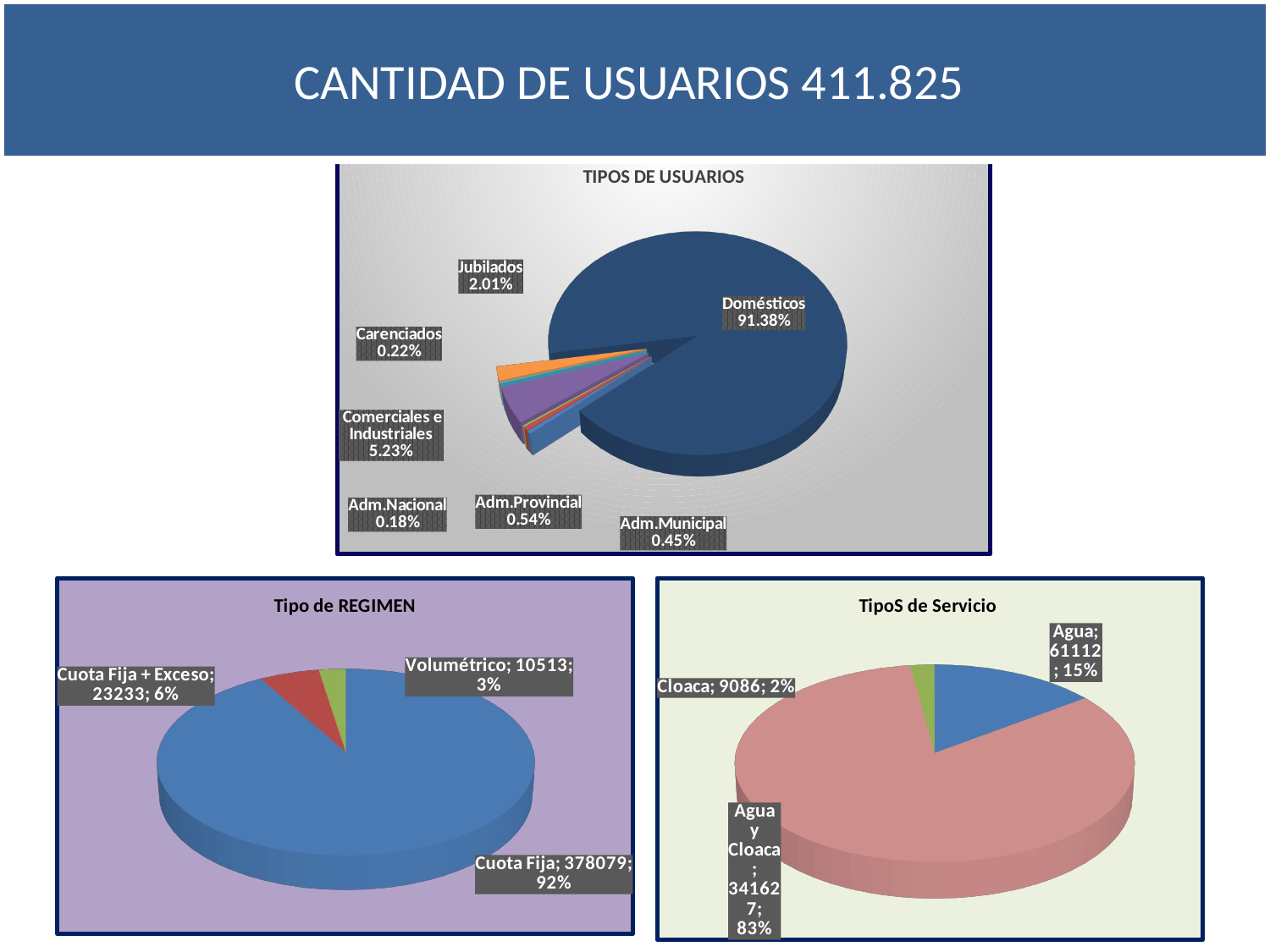
In the 'TIPOS DE USUARIOS' chart, which category has the smallest share? Adm.Nacional In the 'Tipo de REGIMEN' chart, what is the value for Cuota Fija? 378079 In the 'TIPOS DE USUARIOS' chart, how many categories are shown? 7 In the 'TipoS de Servicio' chart, what is the value for Agua y Cloaca? 341627 In the 'TIPOS DE USUARIOS' chart, what is the difference in percentage points between Adm.Provincial and Adm.Municipal? 0.09 In the 'TIPOS DE USUARIOS' chart, which is larger, Jubilados or Adm.Provincial? Jubilados In the 'Tipo de REGIMEN' chart, what share does Volumétrico represent? 3% What type of chart is the 'TipoS de Servicio' chart? Pie chart In the 'TIPOS DE USUARIOS' chart, what share of users is Comerciales e Industriales? 5.23% In the 'TipoS de Servicio' chart, which category has the smallest value? Cloaca In the 'TIPOS DE USUARIOS' chart, what share of users is Domésticos? 91.38% In the 'Tipo de REGIMEN' chart, what is the difference between Cuota Fija + Exceso and Volumétrico? 12720